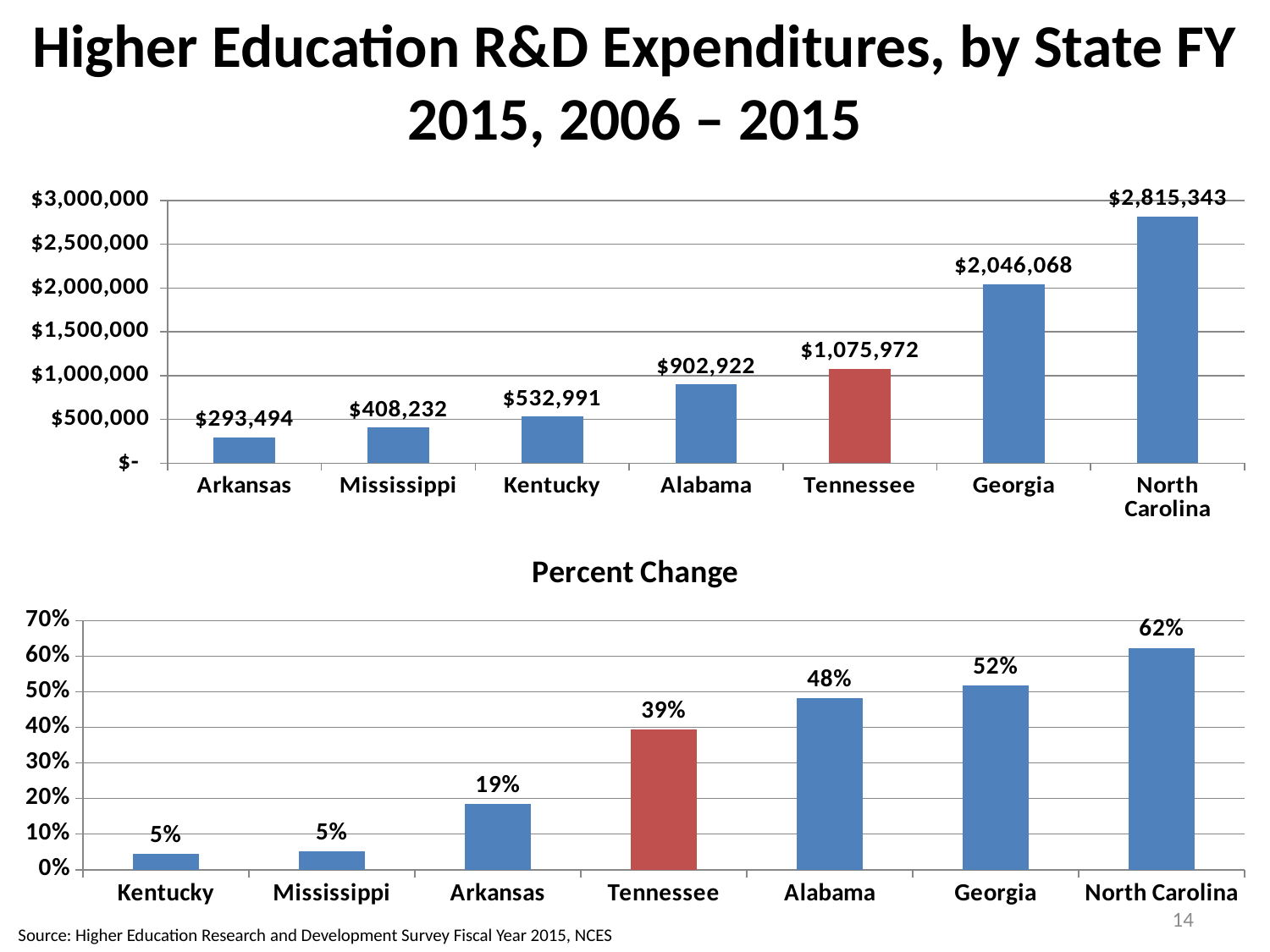
In the top chart, which state has the highest value? North Carolina In the top chart, how many states are shown? 7 In the Percent Change chart, what is the value for Arkansas? 19% In the Percent Change chart, what is the value for Tennessee? 39% In the Percent Change chart, what is the difference between North Carolina and Tennessee? 23 percentage points In the Percent Change chart, which state has the highest value? North Carolina In the top chart, which is larger, the value for Tennessee or the value for Alabama? Tennessee What kind of chart is the Percent Change chart? Bar chart In the top chart, which state has the lowest value? Arkansas In the top chart, what is the difference between North Carolina and Georgia? $769,275 In the top chart, what is the value for Tennessee? $1,075,972 In the top chart, what is the value for Mississippi? $408,232